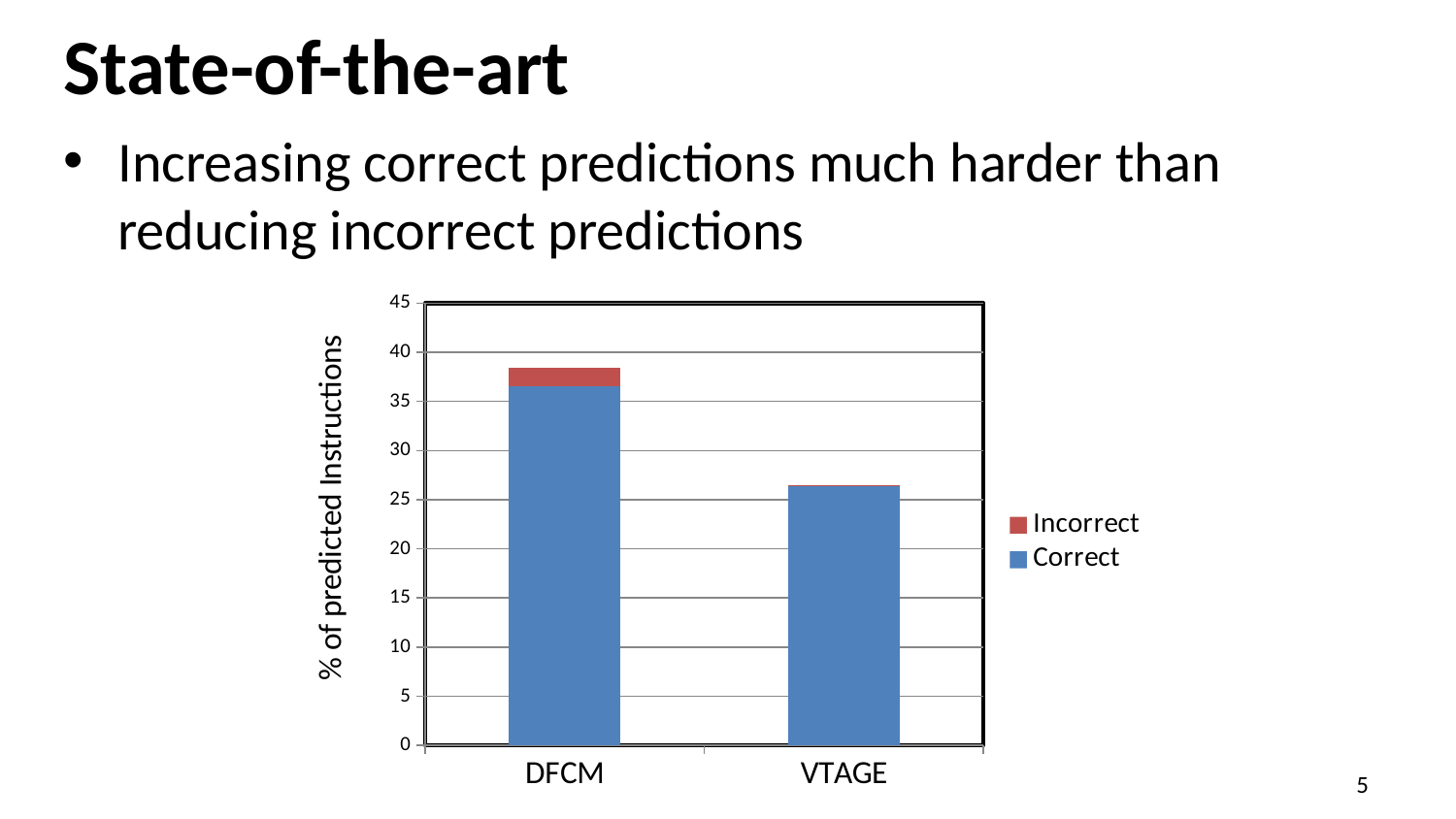
Which colour represents the Incorrect series in the chart? red Is the total stacked value for DFCM greater or less than 35? greater Is the Correct value for DFCM larger or smaller than the Correct value for VTAGE? larger Which category has the taller stacked bar, DFCM or VTAGE? DFCM How many series does the chart's legend list? 2 Is the total stacked value for VTAGE greater or less than 30? less What kind of chart is shown on the slide? stacked bar chart Which category has the shorter stacked bar? VTAGE Is the Correct value for VTAGE greater or less than 25? greater How many categories are shown on the x axis of the chart? 2 What is the label of the chart's y axis? % of predicted Instructions